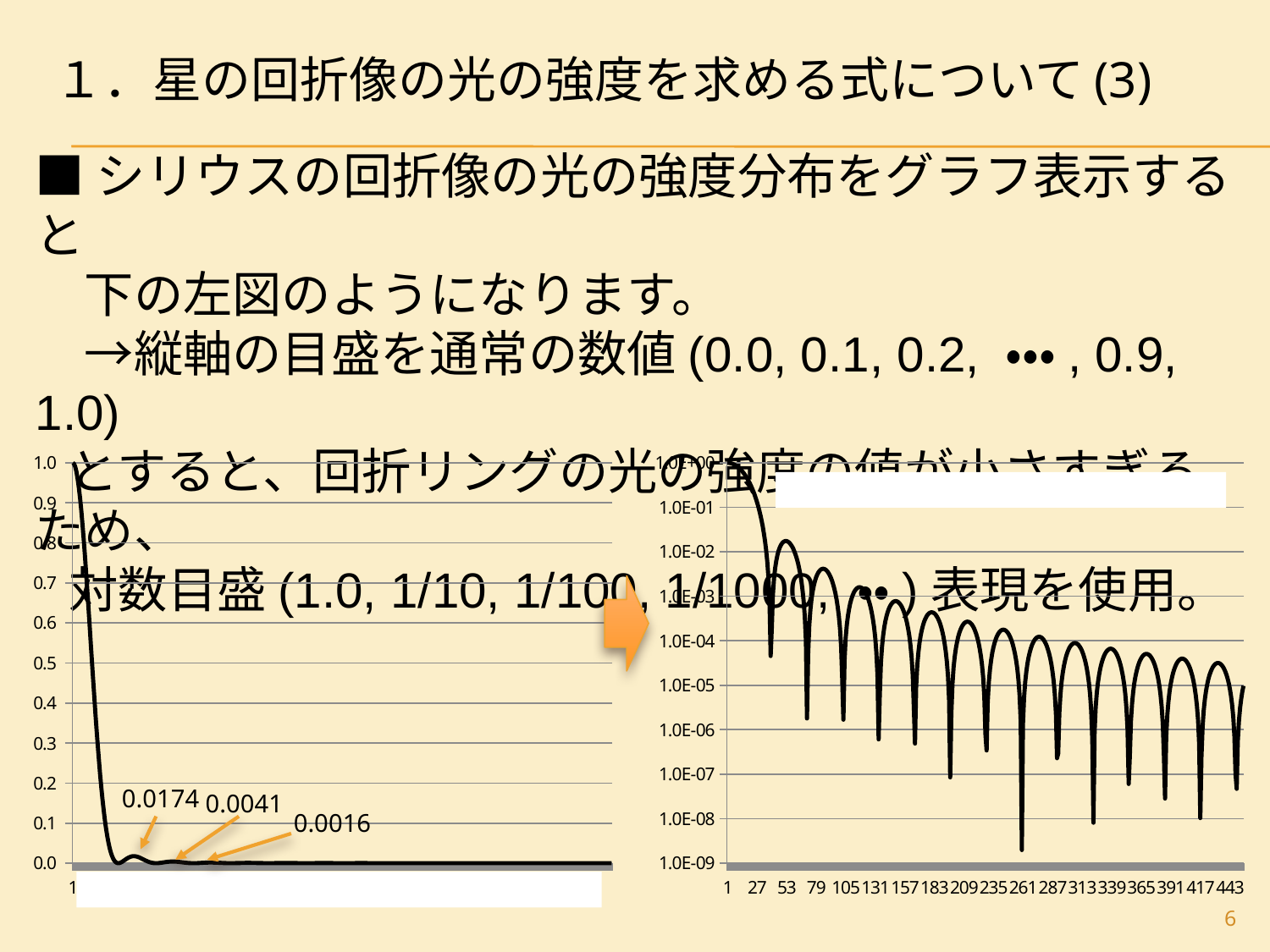
In the left chart, which of the three labeled peak values is the largest? 0.0174 In the left chart, what value is labeled for the third annotated peak? 0.0016 In the left chart, is the value of the curve at its starting point (x = 1) greater or less than 0.9? greater What kind of chart is the left chart on the slide? line chart In the right chart, what is the topmost label on the vertical axis? 1.0E+00 In the left chart, which of the three labeled peak values is the smallest? 0.0016 In the left chart, what value is labeled for the second annotated peak? 0.0041 In the left chart, what is the difference between the labeled values 0.0174 and 0.0041? 0.0133 In the right chart, do the peaks of the curve rise or fall as you move along the x axis? fall What kind of chart is the right chart on the slide? line chart In the left chart, which is larger, the labeled value 0.0041 or 0.0016? 0.0041 In the left chart, what value is labeled for the first diffraction ring peak (the leftmost annotated peak)? 0.0174